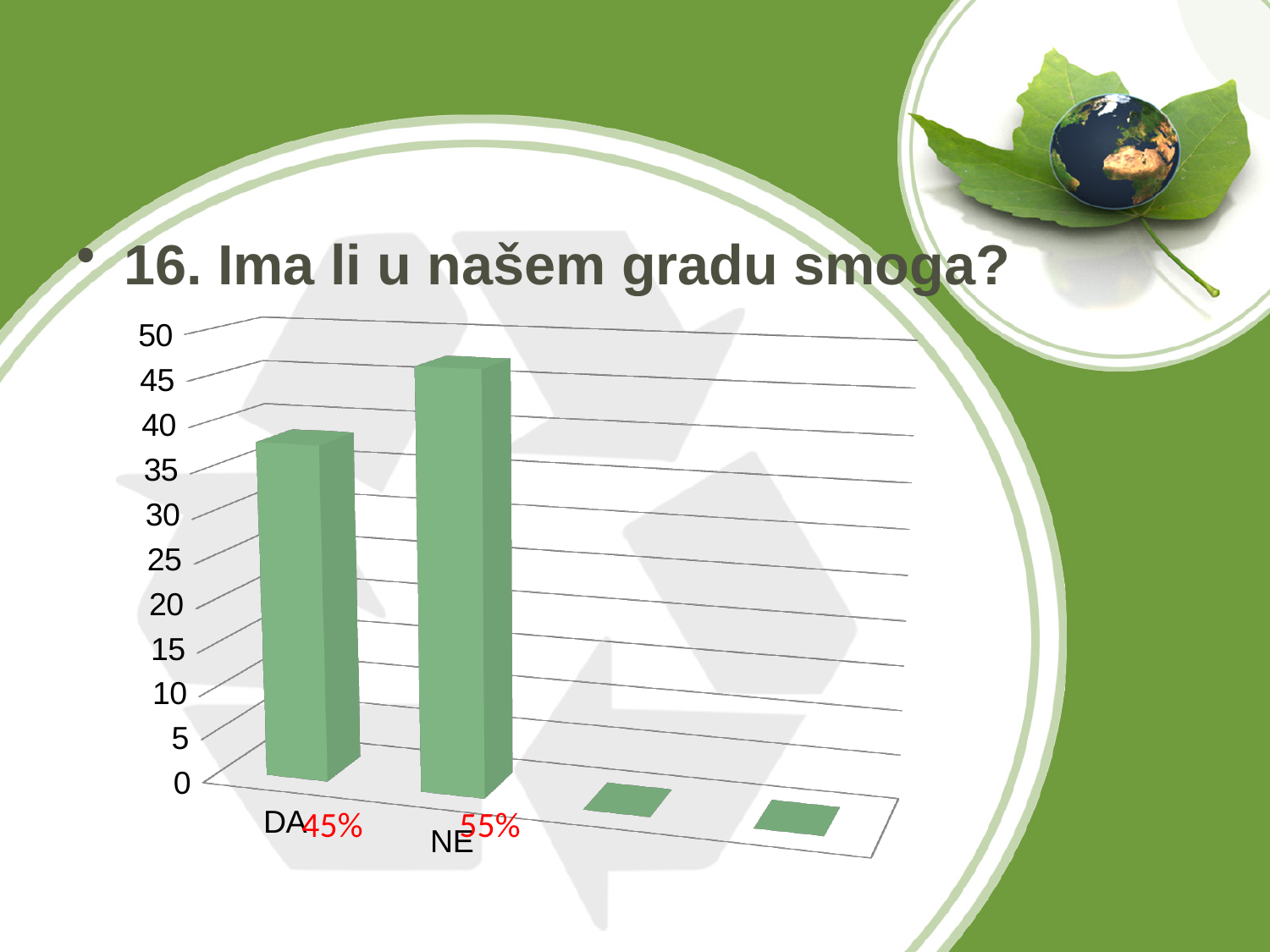
What percentage is shown for the NE category? 55% What kind of chart is shown on the slide? bar chart What percentage is shown for the DA category? 45% What is the difference between the percentages shown for NE and DA? 10% Which is larger, the value for DA or the value for NE? NE Is the bar for DA greater or less than 30 on the vertical axis? greater Which category has the highest value, DA or NE? NE What colour are the bars in the chart? green Which category has the lowest value, DA or NE? DA What is the title of the chart on the slide? 16. Ima li u našem gradu smoga? Is the bar for NE greater or less than 40 on the vertical axis? greater Is the bar for DA greater or less than 45 on the vertical axis? less